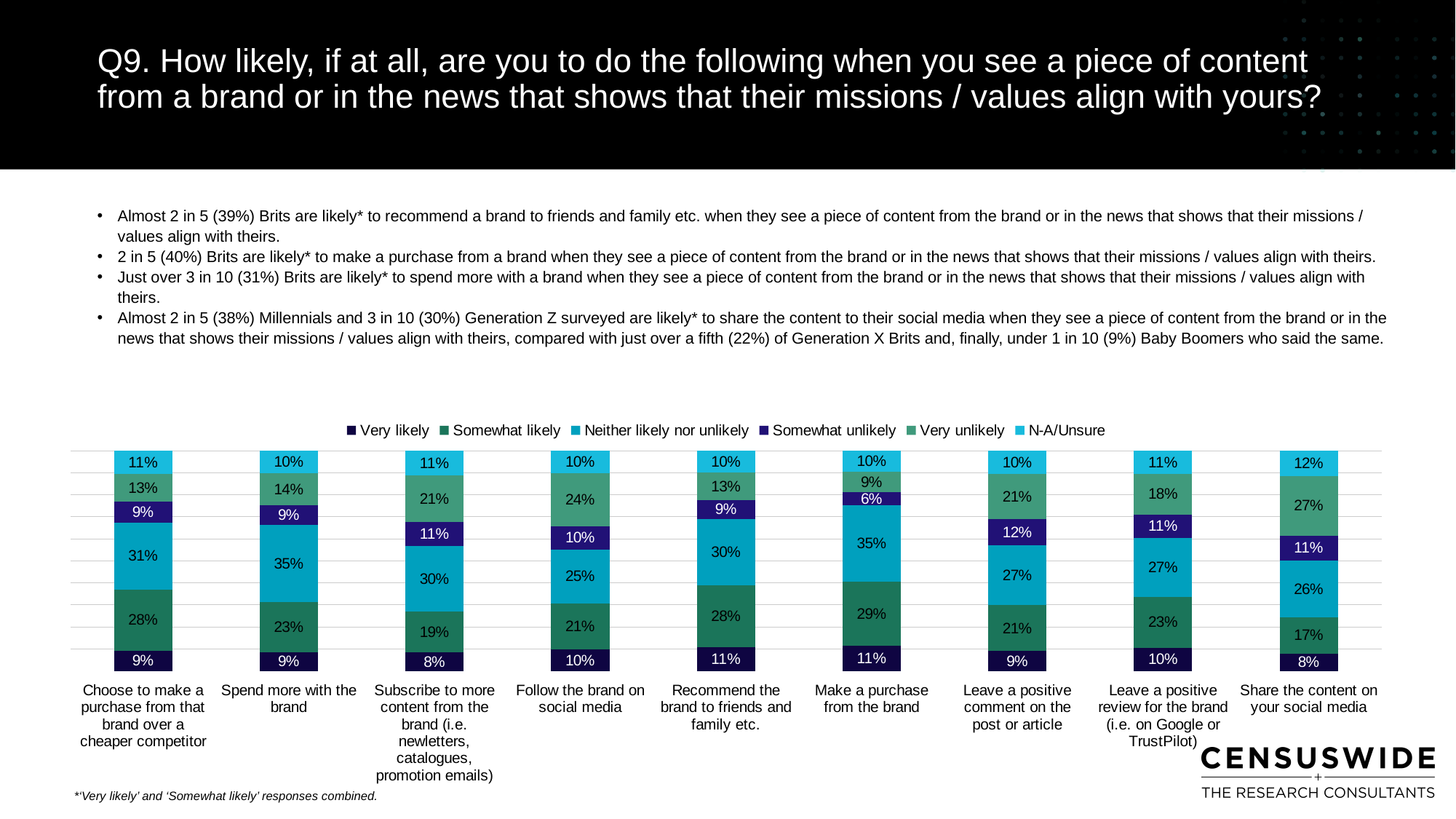
What is the 'Very unlikely' value for 'Share the content on your social media'? 27% What is the 'Neither likely nor unlikely' value for 'Spend more with the brand'? 35% Is the 'Somewhat likely' value larger for 'Choose to make a purchase from that brand over a cheaper competitor' or for 'Subscribe to more content from the brand'? Choose to make a purchase from that brand over a cheaper competitor Which series is listed first in the chart legend? Very likely What percentage of respondents are 'Very likely' to recommend the brand to friends and family etc.? 11% How many categories are shown on the x axis of the chart? 9 What is the combined total of 'Very likely' and 'Somewhat likely' for 'Leave a positive review for the brand (i.e. on Google or TrustPilot)'? 33% Which category has the highest 'Somewhat likely' value? Make a purchase from the brand Which category has the lowest 'Somewhat unlikely' value? Make a purchase from the brand What is the difference between the 'Very unlikely' values for 'Follow the brand on social media' and 'Make a purchase from the brand'? 15% How many series does the legend list? 6 What kind of chart is shown on the slide? Stacked bar chart